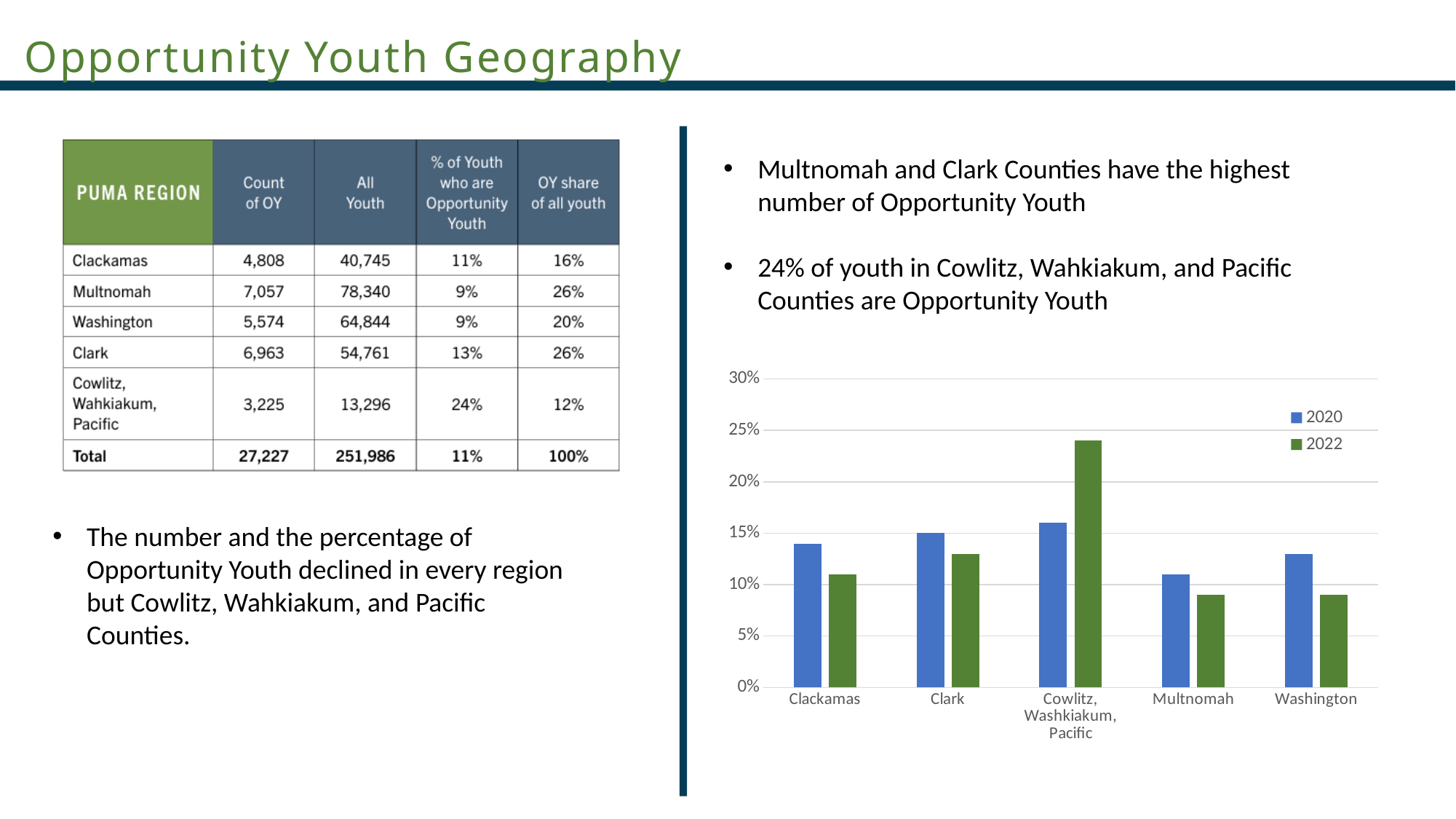
For Clackamas, which is larger in the chart: the 2020 value or the 2022 value? 2020 What colour are the 2022 bars in the chart? Green For Cowlitz, Washkiakum, Pacific, which is larger in the chart: the 2020 value or the 2022 value? 2022 Which region has the highest 2022 value in the chart? Cowlitz, Washkiakum, Pacific How many regions are shown on the x axis of the chart? 5 Which region has the lowest 2020 value in the chart? Multnomah Is the 2022 value for Washington greater or less than 10%? less Is the 2022 value for Multnomah greater or less than 10%? less Is the 2022 value for Cowlitz, Washkiakum, Pacific greater or less than 20%? greater How many series does the chart's legend list? 2 What kind of chart is shown on the slide? Bar chart